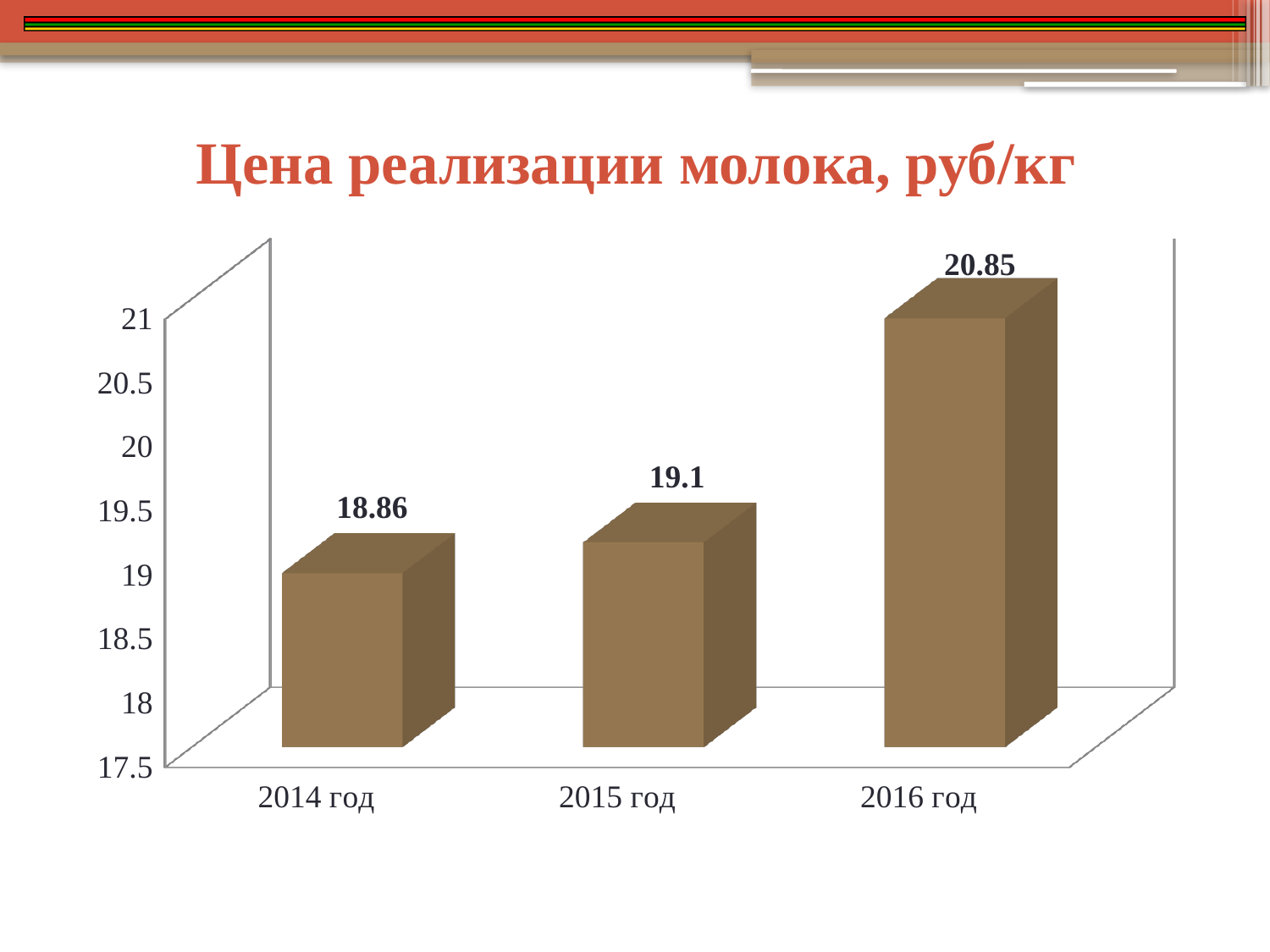
What is the milk sale price for 2015 год? 19.1 What is the milk sale price for 2014 год? 18.86 What kind of chart is shown on the slide? bar chart Is the milk sale price for 2016 год greater or less than 20? greater Which is larger, the milk sale price in 2014 год or in 2016 год? 2016 год Which year has the lowest milk sale price? 2014 год How many years are shown on the chart? 3 Does the milk sale price rise or fall from 2014 год to 2016 год? rise What is the difference between the milk sale price in 2016 год and 2015 год? 1.75 What is the milk sale price for 2016 год? 20.85 Which year has the highest milk sale price? 2016 год What is the difference between the milk sale price in 2015 год and 2014 год? 0.24